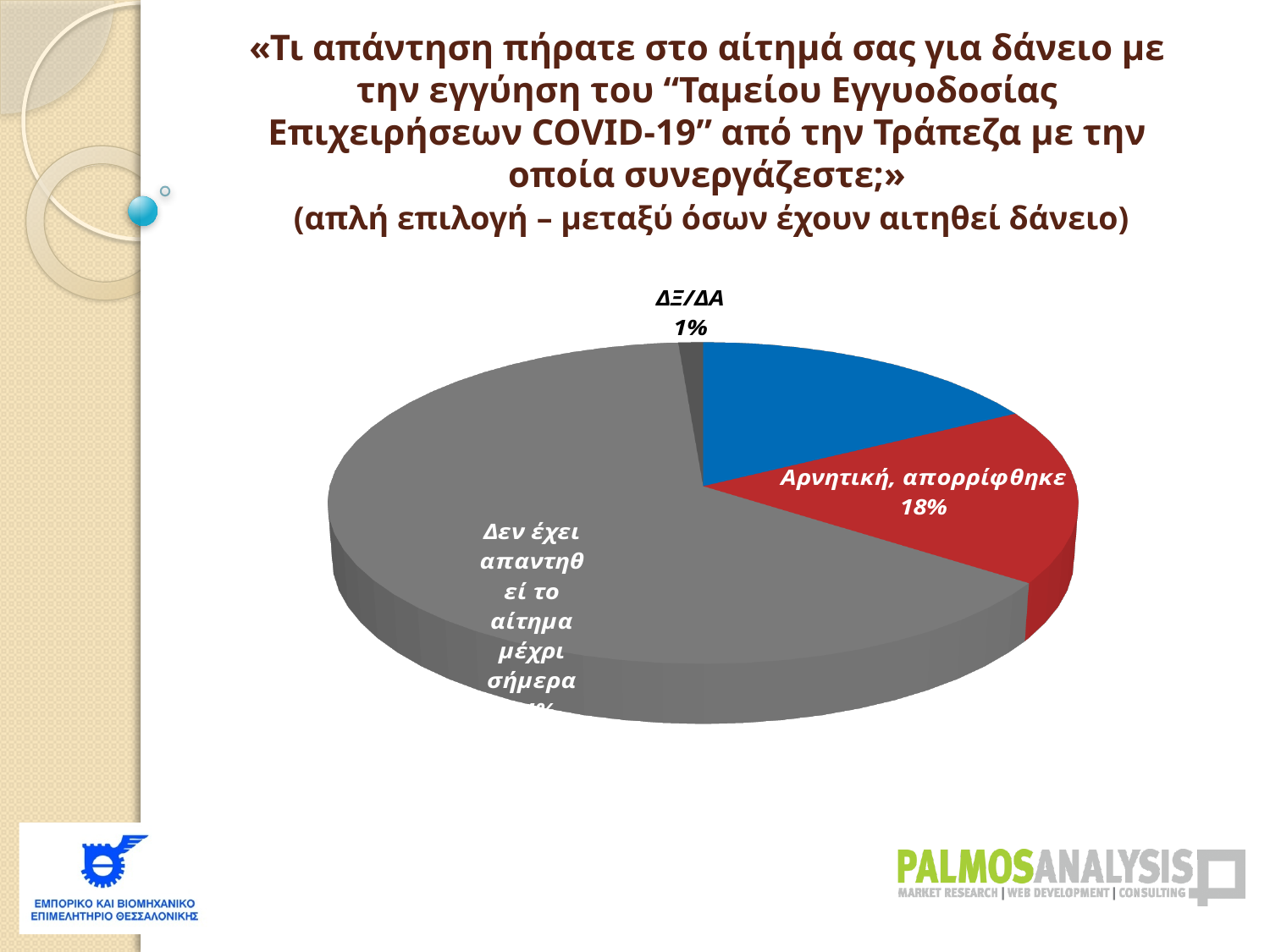
Which slice of the pie chart is the smallest? ΔΞ/ΔΑ What percentage of the pie chart is labelled "Αρνητική, απορρίφθηκε"? 18% Which is larger in the pie chart: "Δεν έχει απαντηθεί το αίτημα μέχρι σήμερα" or "Αρνητική, απορρίφθηκε"? Δεν έχει απαντηθεί το αίτημα μέχρι σήμερα Which is larger in the pie chart: "Αρνητική, απορρίφθηκε" or "ΔΞ/ΔΑ"? Αρνητική, απορρίφθηκε What colour is the largest slice of the pie chart? Grey What percentage does the "ΔΞ/ΔΑ" slice of the pie chart represent? 1% What colour is the "Αρνητική, απορρίφθηκε" slice of the pie chart? Red How many slices does the pie chart have? 4 What kind of chart is shown on the slide? Pie chart Which slice of the pie chart is the largest? Δεν έχει απαντηθεί το αίτημα μέχρι σήμερα By how many percentage points does "Αρνητική, απορρίφθηκε" exceed "ΔΞ/ΔΑ" in the pie chart? 17 percentage points